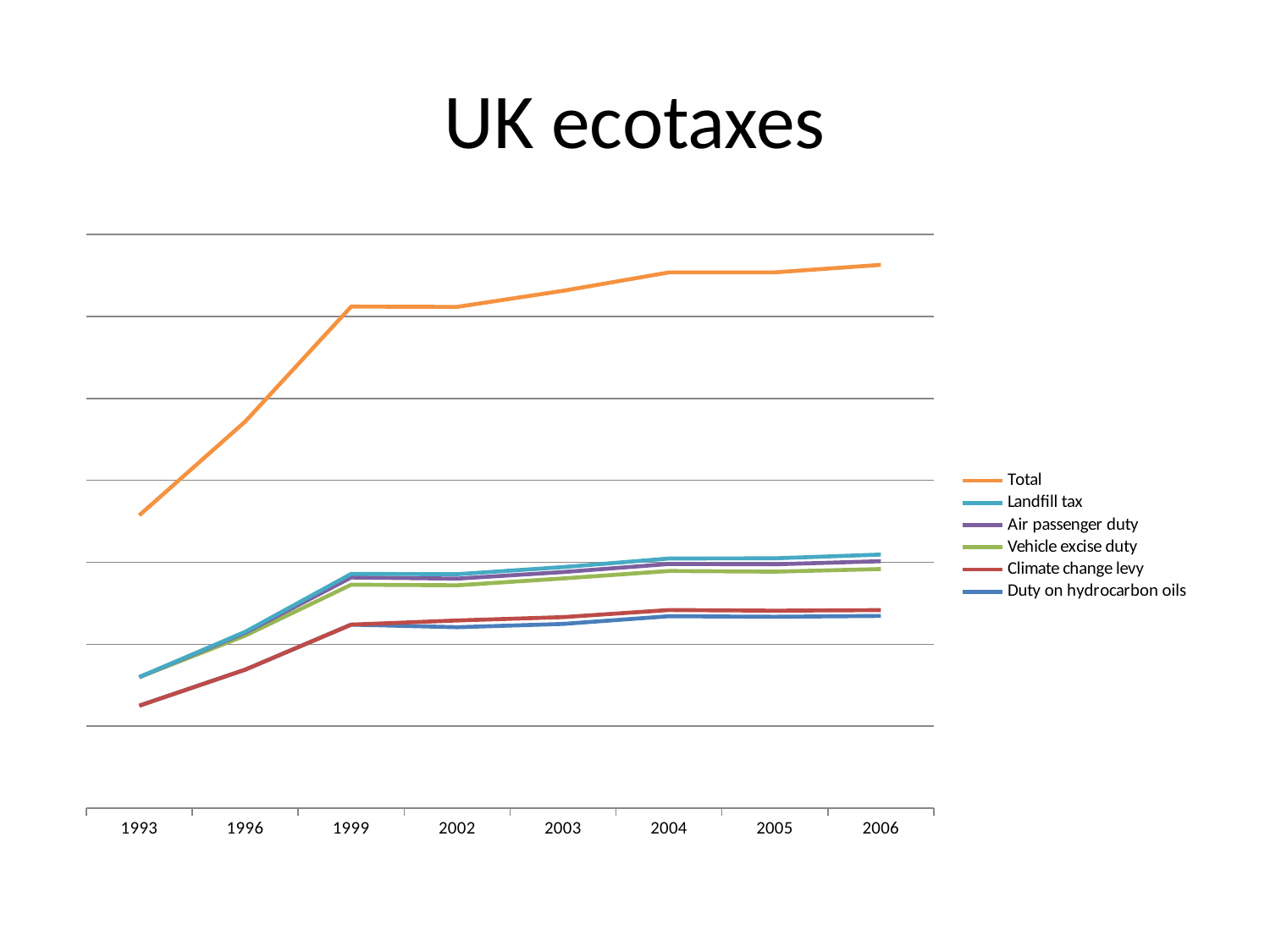
How many years are labelled along the x axis? 8 How many series does the legend list? 6 Does the Total line rise or fall from 1993 to 2006? Rises Which series is plotted in orange? Total What kind of chart is shown on the slide? Line chart What is the title of the chart? UK ecotaxes Which series has the highest values across the whole chart? Total What is the first year shown on the x axis? 1993 Does the Total line rise or fall between 1993 and 1999? Rises